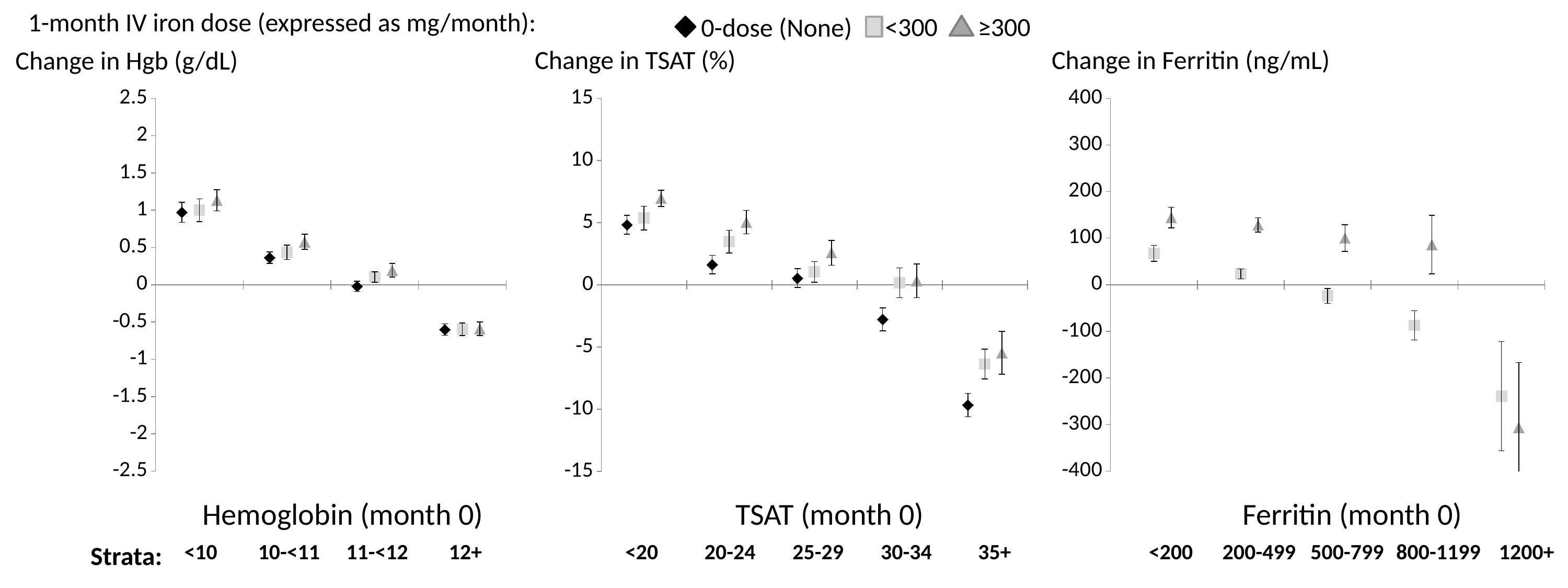
How many charts are shown on the slide? 3 In the Change in TSAT chart, is the value for the 0-dose (None) series in the 35+ stratum greater or less than -5? less In the Change in Ferritin chart, in which stratum is the ≥300 series lowest? 1200+ In the Change in Hgb chart, is the value for the 0-dose (None) series in the <10 stratum greater or less than 0.5? greater In the Change in TSAT chart, is the value for the ≥300 series in the <20 stratum greater or less than 5? greater In the Change in Hgb chart, do the values for the 0-dose (None) series rise or fall as the hemoglobin strata increase? fall In the Change in Hgb chart, how many strata are shown on the x axis? 4 In the Change in TSAT chart, which is larger in the 20-24 stratum: the ≥300 series or the 0-dose (None) series? ≥300 In the Change in TSAT chart, how many strata are shown on the x axis? 5 How many series does the legend at the top of the slide list? 3